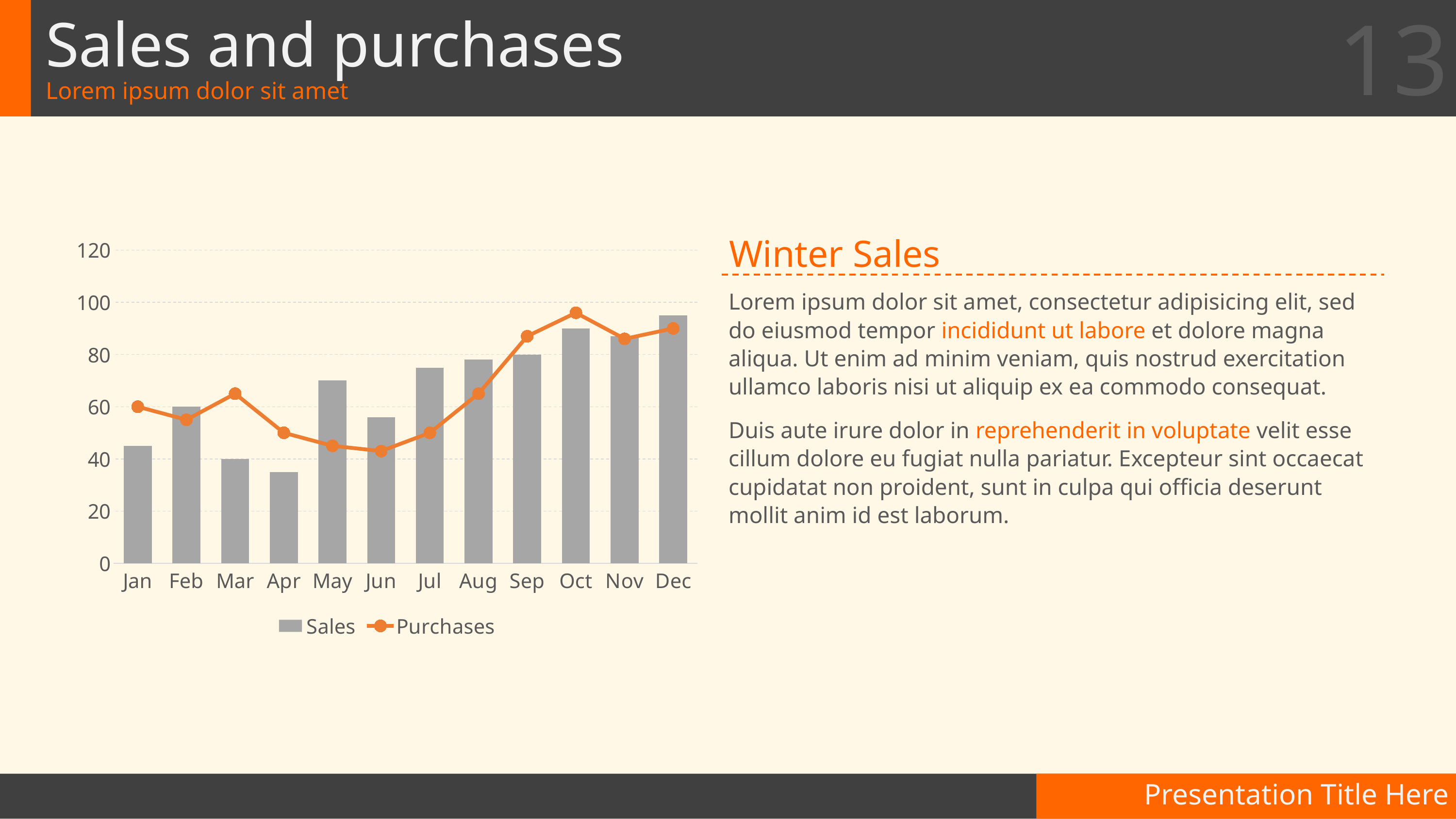
How many months are shown on the x axis of the chart? 12 Is the Purchases value for Oct greater or less than 80? greater What kind of chart is shown on the slide? A combined bar and line chart Do the Sales bars rise or fall from Jul to Dec? Rise What is the Sales value for Mar? 40 Is the Sales value for Apr greater or less than 40? less In which month does the Purchases line reach its highest point? Oct What is the Purchases value for Jan? 60 Which month has the lowest Sales bar? Apr Which is larger, the Sales value for Oct or the Sales value for Jul? Oct Which month has the highest Sales bar? Dec How many series does the chart legend list? 2